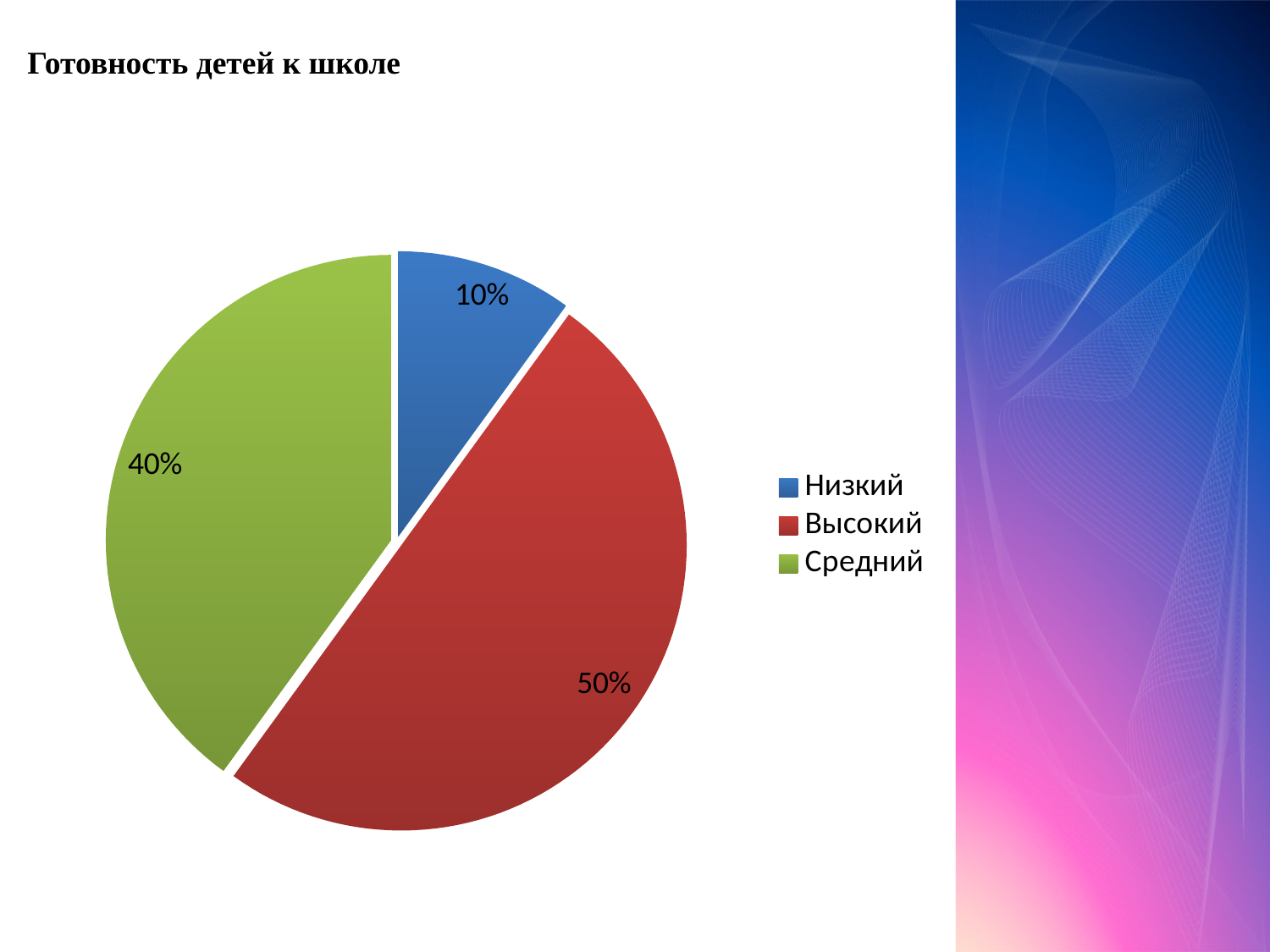
What share of the pie does Средний represent? 40% Which colour represents Высокий in the legend? Red What share of the pie does Низкий represent? 10% Which is larger, the share for Средний or the share for Низкий? Средний What kind of chart is shown on the slide? Pie chart What share of the pie does Высокий represent? 50% Which category has the smallest slice of the pie? Низкий How many categories does the pie chart show? 3 Which category has the largest slice of the pie? Высокий What is the title of the slide above the chart? Готовность детей к школе What is the difference in percentage points between Высокий and Средний? 10% What is the difference in percentage points between Средний and Низкий? 30%